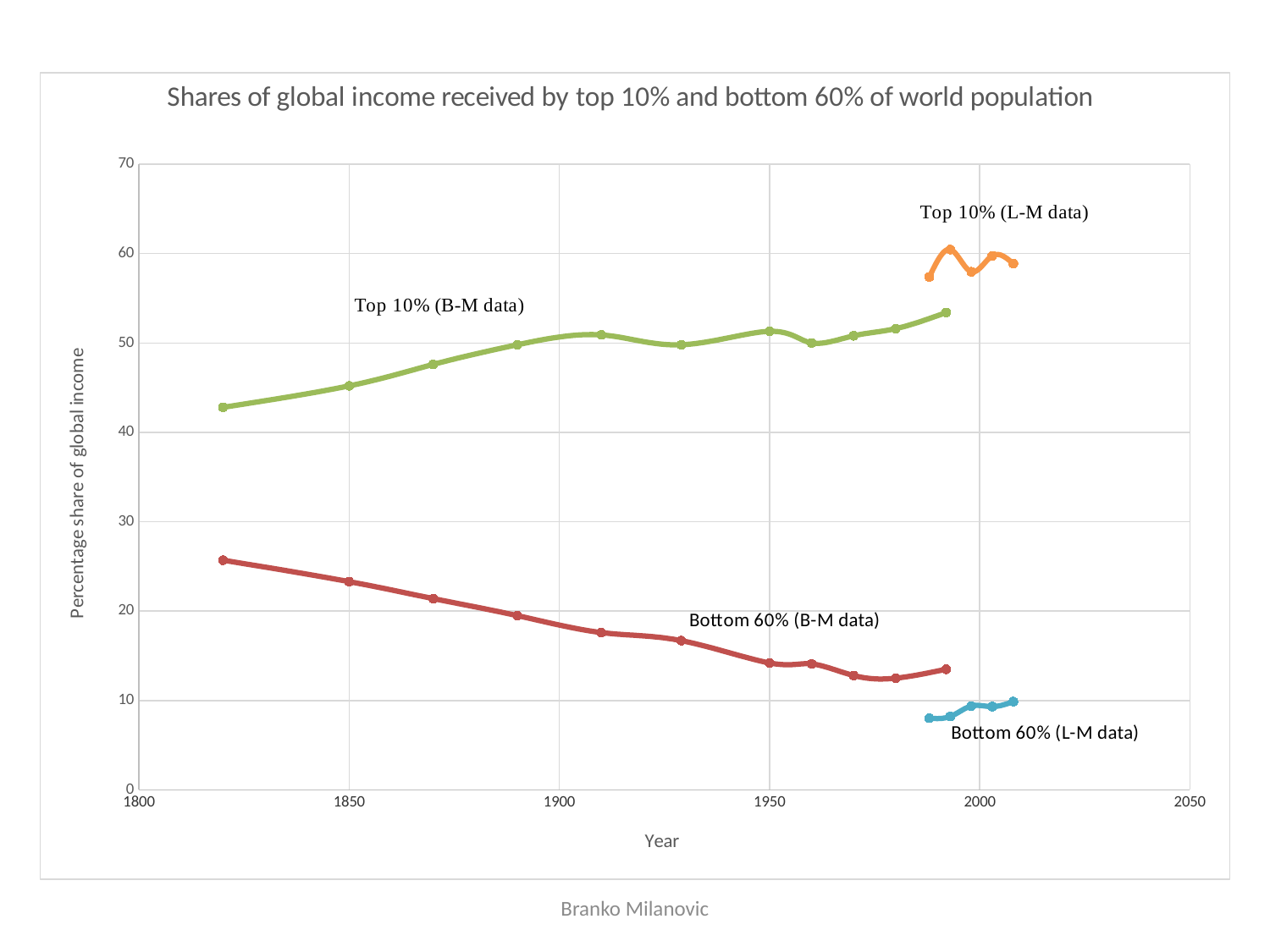
Does the Bottom 60% (B-M data) series rise or fall from 1820 to 1980? fall Is the value for Top 10% (B-M data) in 1820 greater or less than 40? greater What is the title of the chart? Shares of global income received by top 10% and bottom 60% of world population What is the label on the vertical axis of the chart? Percentage share of global income Is the value for Bottom 60% (B-M data) in 1820 greater or less than 20? greater How many data series (lines) are plotted on the chart? 4 What kind of chart is shown on the slide? line chart Are the values for Top 10% (L-M data) greater or less than 50? greater In 1950, which series has the larger value: Top 10% (B-M data) or Bottom 60% (B-M data)? Top 10% (B-M data) Does the Top 10% (B-M data) series rise or fall from 1820 to the 1990s? rise